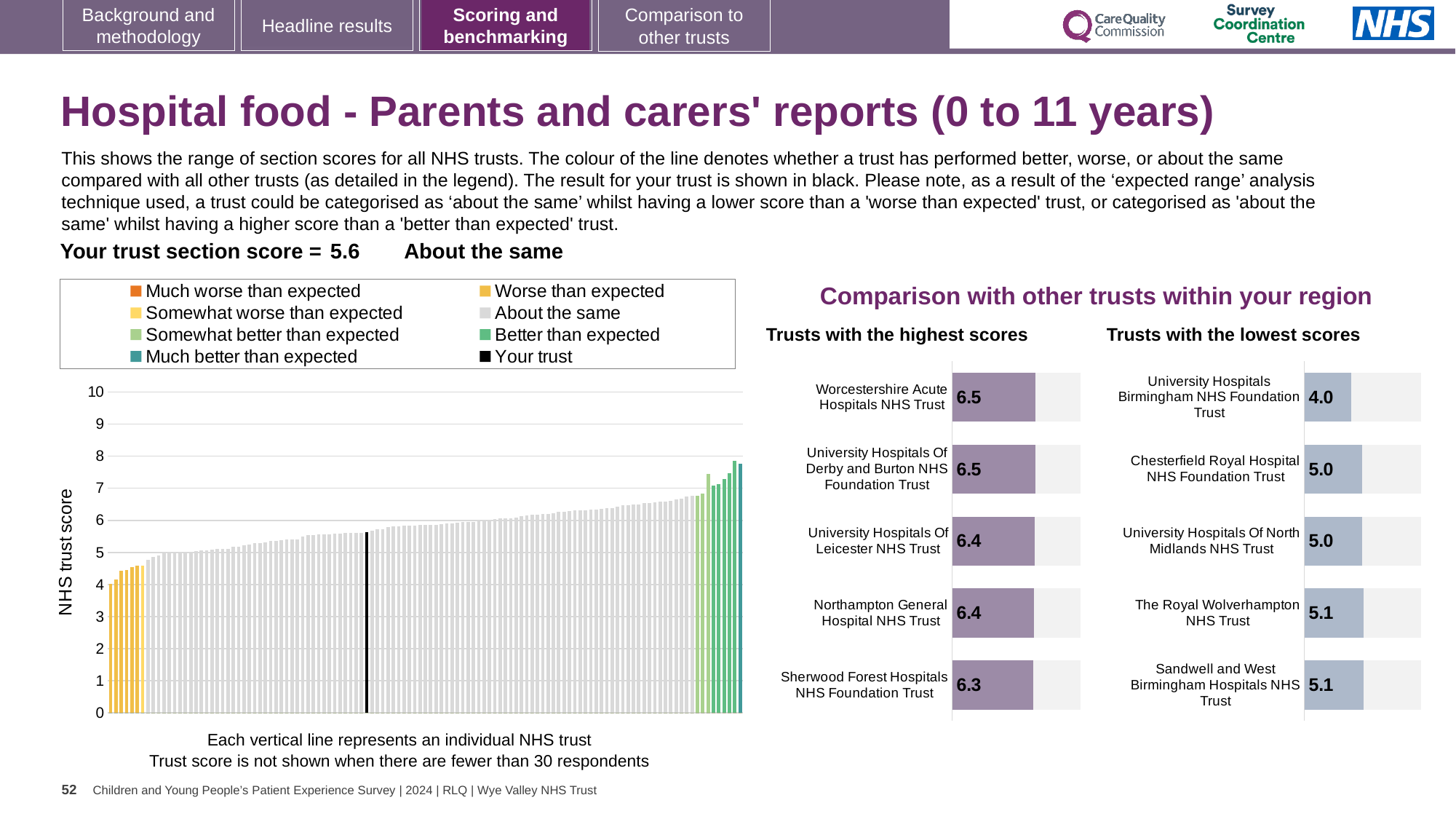
How many trusts are shown in the 'Trusts with the highest scores' chart? 5 In the 'Trusts with the lowest scores' chart, what is the difference between the scores of Sandwell and West Birmingham Hospitals NHS Trust and University Hospitals Birmingham NHS Foundation Trust? 1.1 In the 'Trusts with the highest scores' chart, what is the difference between the scores of Worcestershire Acute Hospitals NHS Trust and Sherwood Forest Hospitals NHS Foundation Trust? 0.2 In the 'Trusts with the lowest scores' chart, what is the score for University Hospitals Birmingham NHS Foundation Trust? 4.0 In the 'Trusts with the highest scores' chart, what is the score for Sherwood Forest Hospitals NHS Foundation Trust? 6.3 In the main 'NHS trust score' chart on the left, is the value for the black 'Your trust' bar greater or less than 5? greater In the 'Trusts with the highest scores' chart, which trust has the lowest score? Sherwood Forest Hospitals NHS Foundation Trust In the main 'NHS trust score' chart on the left, do the bar values rise or fall from left to right? rise In the 'Trusts with the lowest scores' chart, what is the score for The Royal Wolverhampton NHS Trust? 5.1 In the 'Trusts with the lowest scores' chart, which trust has the lowest score? University Hospitals Birmingham NHS Foundation Trust In the 'Trusts with the highest scores' chart, what is the score for Worcestershire Acute Hospitals NHS Trust? 6.5 In the 'Trusts with the lowest scores' chart, which has the larger score: Chesterfield Royal Hospital NHS Foundation Trust or University Hospitals Birmingham NHS Foundation Trust? Chesterfield Royal Hospital NHS Foundation Trust